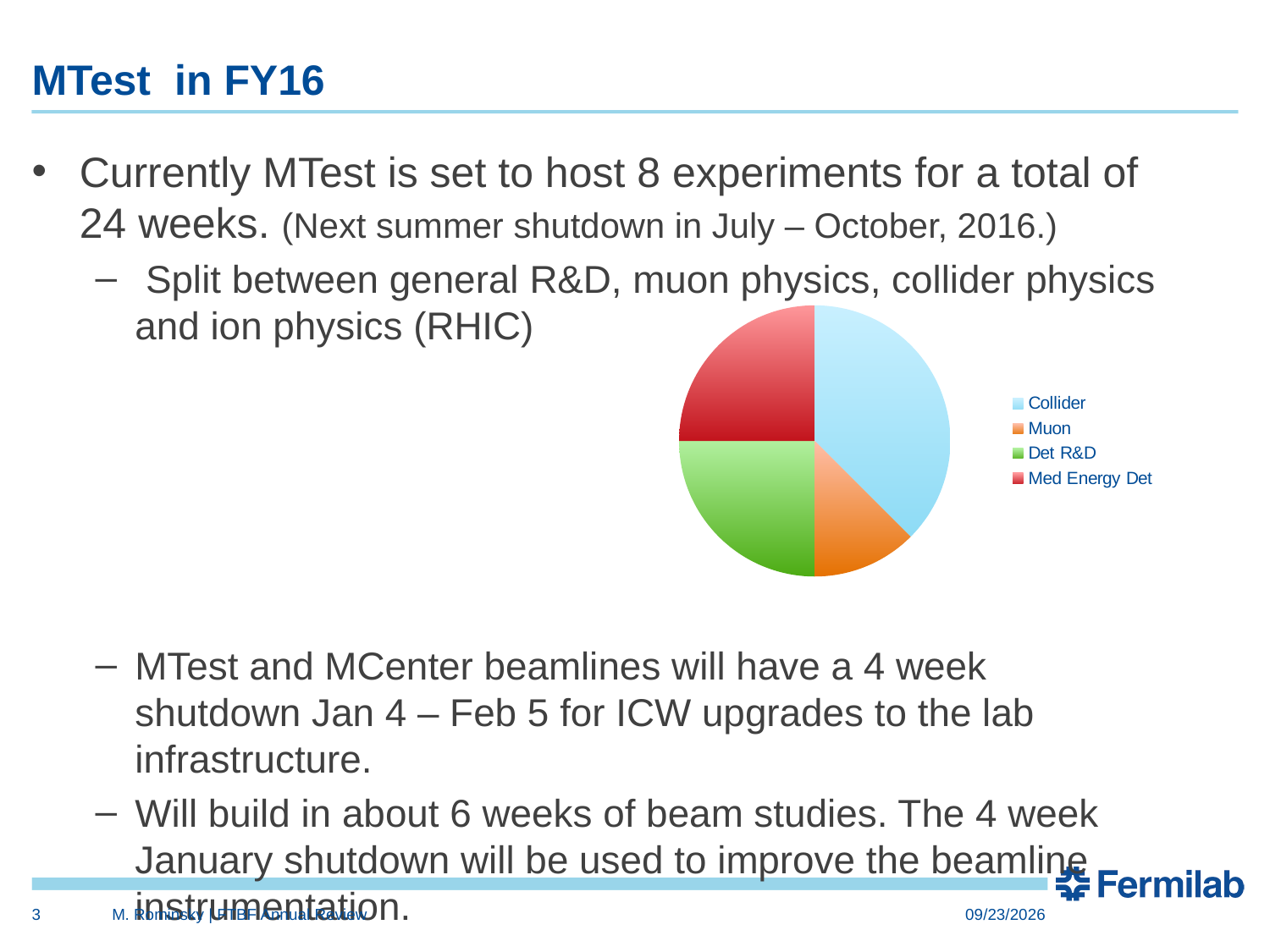
Which slice is larger in the pie chart, Det R&D or Muon? Det R&D Which category has the largest slice of the pie chart? Collider Which category does the red slice of the pie chart represent? Med Energy Det Which slice is larger in the pie chart, Collider or Det R&D? Collider How many slices does the pie chart have? 4 Which slice is larger in the pie chart, Collider or Muon? Collider How many entries does the legend of the pie chart list? 4 What kind of chart is shown on the slide? pie chart What colour is the Muon slice in the pie chart? orange Which category has the smallest slice of the pie chart? Muon